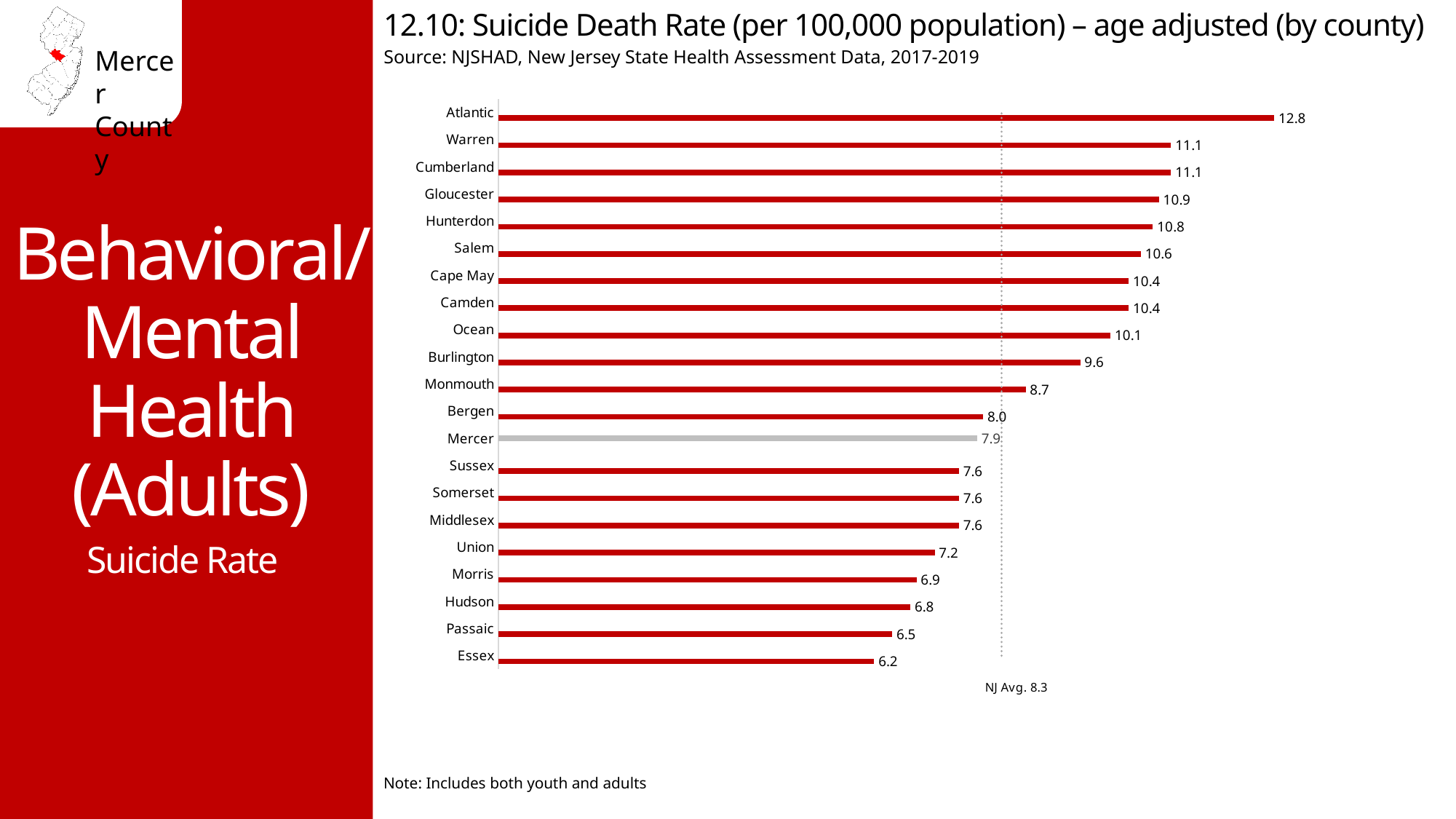
What is the suicide death rate for Atlantic County? 12.8 What is the difference between Mercer County's suicide death rate and the NJ average? 0.4 Which county has the lowest suicide death rate? Essex Which county has a higher suicide death rate, Bergen or Mercer? Bergen Which county has the highest suicide death rate? Atlantic What is the difference between the suicide death rates of Atlantic and Essex counties? 6.6 What is the suicide death rate for Mercer County? 7.9 What is the suicide death rate for Essex County? 6.2 What is the NJ average suicide death rate shown on the chart? 8.3 Which county's bar is shown in gray rather than red? Mercer What type of chart is shown on the slide? Bar chart How many counties are shown in the chart? 21